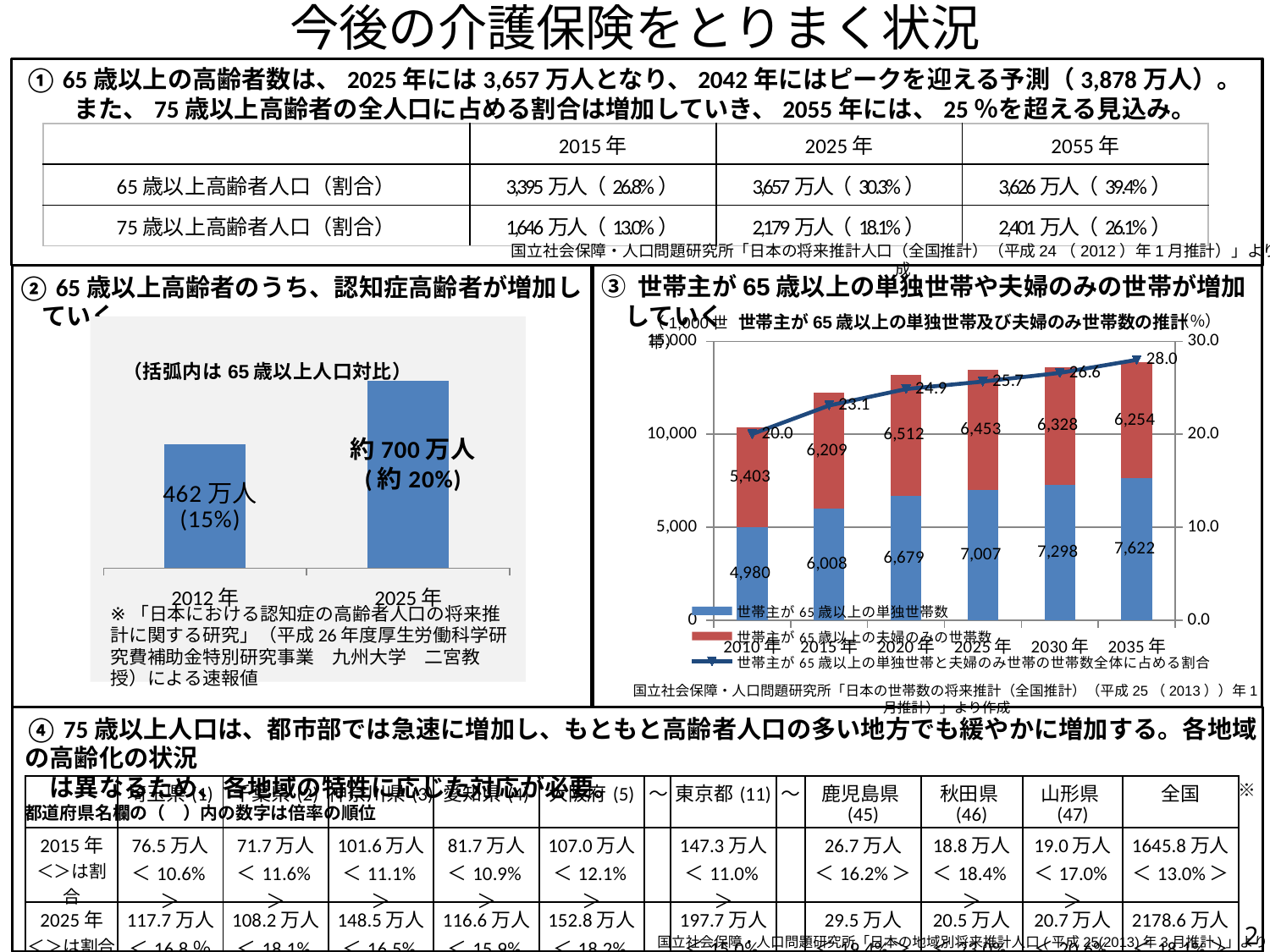
In the right chart (世帯主が65歳以上の単独世帯及び夫婦のみ世帯数の推計), how many series does the legend list? 3 In the right chart (世帯主が65歳以上の単独世帯及び夫婦のみ世帯数の推計), what is the value of 世帯主が65歳以上の単独世帯数 for 2010年? 4,980 In the right chart (世帯主が65歳以上の単独世帯及び夫婦のみ世帯数の推計), what percentage does the line show for 2035年? 28.0 In the right chart (世帯主が65歳以上の単独世帯及び夫婦のみ世帯数の推計), does the percentage line rise or fall from 2010年 to 2035年? rise In the left chart (認知症高齢者), what is the value shown for 2012年? 462万人 (15%) In the left chart (認知症高齢者), how many bars are plotted? 2 In the right chart (世帯主が65歳以上の単独世帯及び夫婦のみ世帯数の推計), what is the value of 世帯主が65歳以上の夫婦のみの世帯数 for 2020年? 6,512 In the left chart (認知症高齢者), what is the value shown for 2025年? 約700万人 (約20%) In the right chart (世帯主が65歳以上の単独世帯及び夫婦のみ世帯数の推計), which year has the highest value for 世帯主が65歳以上の単独世帯数? 2035年 What kind of chart is the left chart (認知症高齢者)? bar chart In the right chart (世帯主が65歳以上の単独世帯及び夫婦のみ世帯数の推計), what is the difference between the 単独世帯数 values for 2035年 and 2010年? 2,642 In the right chart (世帯主が65歳以上の単独世帯及び夫婦のみ世帯数の推計), what is the total of the stacked bar for 2015年? 12,217